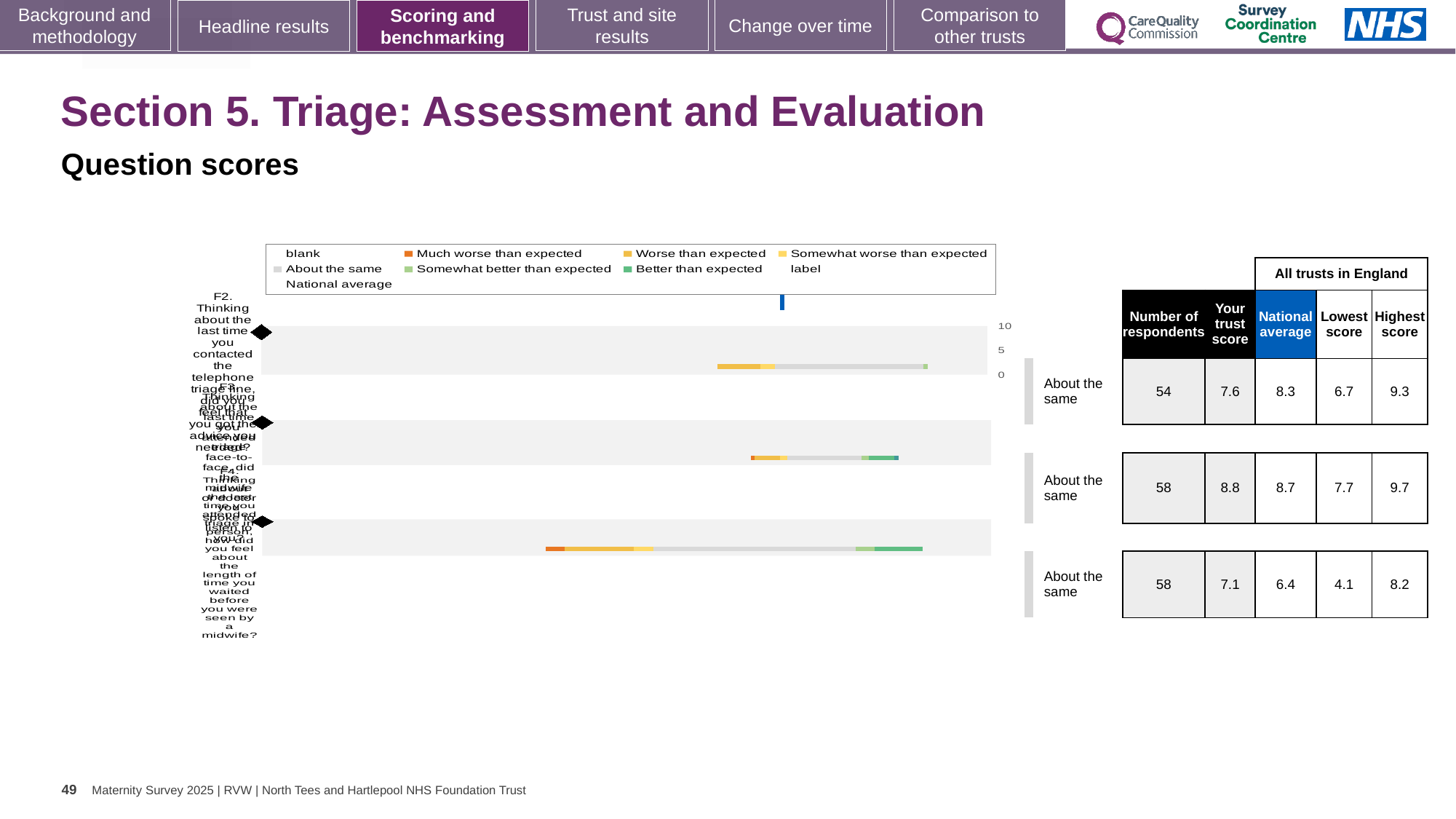
In the table next to the chart, what is the difference between the 'Highest score' and 'Lowest score' in the third row? 4.1 In the chart legend, what colour is used for 'Better than expected'? green In the table next to the chart, what is the 'Lowest score' in the third row? 4.1 In the table next to the chart, in the first row, which is larger: 'Your trust score' or 'National average'? National average What kind of chart is shown on the slide? bar chart How many question bars are plotted in the chart? 3 In the chart legend, what colour is used for 'Much worse than expected'? orange In the table next to the chart, what is the 'Your trust score' in the first row? 7.6 In the table next to the chart, what is the 'Number of respondents' in the first row? 54 In the table next to the chart, what is the 'National average' in the second row? 8.7 In the table next to the chart, what is the 'Highest score' in the second row? 9.7 In the table next to the chart, which row has the highest 'Your trust score'? second row (8.8)